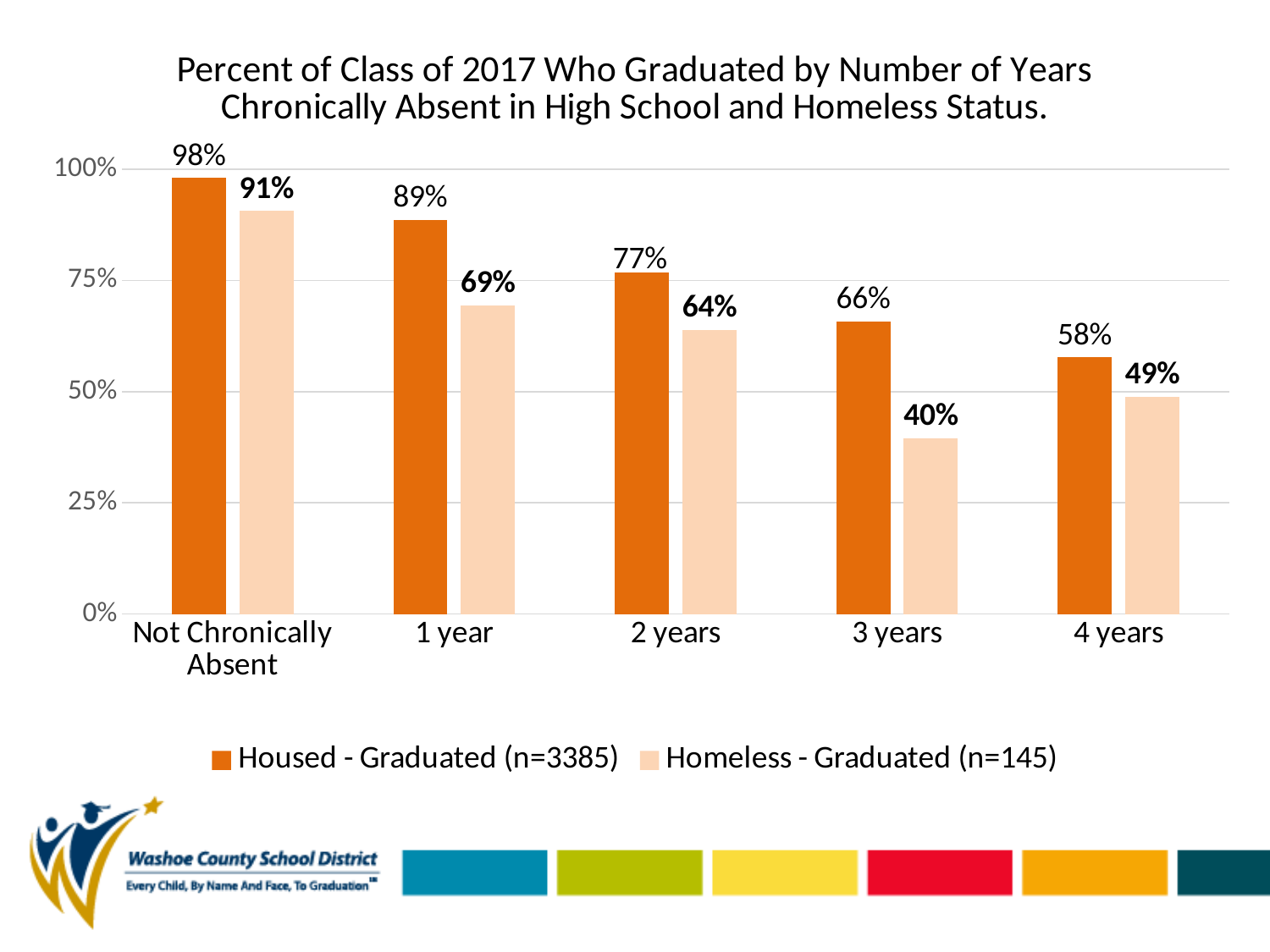
What kind of chart is shown on the slide? Bar chart What is the value for Homeless - Graduated at 3 years? 40% Which category has the lowest value for Homeless - Graduated? 3 years What is the difference between Housed - Graduated and Homeless - Graduated at 3 years? 26% Which is larger: Homeless - Graduated at 1 year or Homeless - Graduated at 2 years? Homeless - Graduated at 1 year What is the value for Homeless - Graduated for Not Chronically Absent? 91% What is the value for Housed - Graduated at 2 years? 77% How many categories are shown on the x axis? 5 How many series does the legend list? 2 Do the Housed - Graduated values rise or fall as the number of years chronically absent increases? Fall Which category has the highest value for Housed - Graduated? Not Chronically Absent What is the sample size (n) given in the legend for Homeless - Graduated? 145